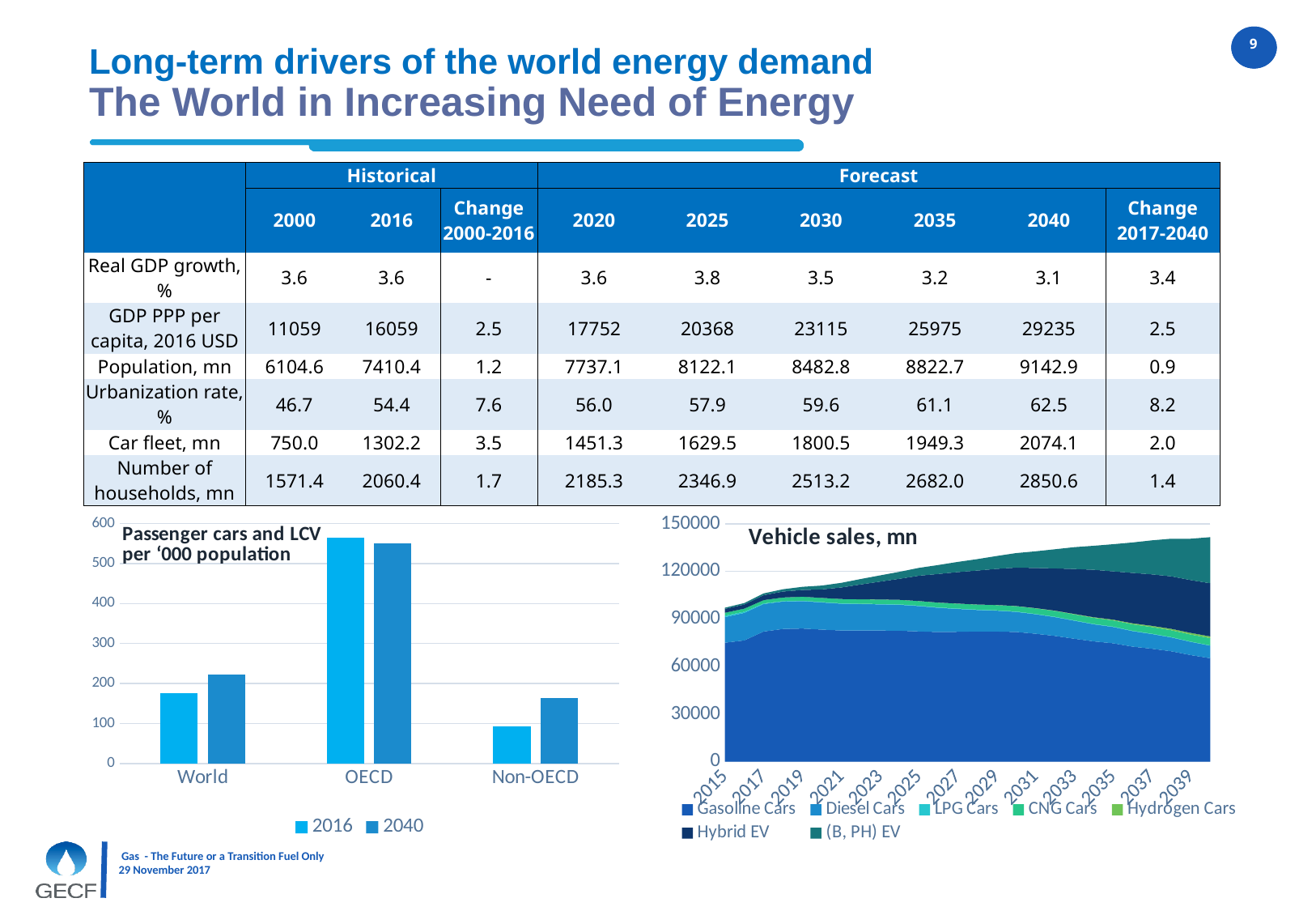
How many series does the legend of the 'Vehicle sales, mn' chart list? 7 In the 'Passenger cars and LCV per '000 population' chart, which category has the lowest 2016 value? Non-OECD How many series does the legend of the 'Passenger cars and LCV per '000 population' chart list? 2 How many categories are shown on the x axis of the 'Passenger cars and LCV per '000 population' chart? 3 In the 'Passenger cars and LCV per '000 population' chart, which is larger for Non-OECD: the 2016 value or the 2040 value? 2040 In the 'Passenger cars and LCV per '000 population' chart, is the 2016 value for OECD greater or less than 500? greater What kind of chart is the 'Passenger cars and LCV per '000 population' chart? bar chart What is the title of the chart on the right side of the slide? Vehicle sales, mn In the 'Passenger cars and LCV per '000 population' chart, is the 2040 value for World greater or less than 200? greater In the 'Passenger cars and LCV per '000 population' chart, which category has the highest values? OECD In the 'Vehicle sales, mn' chart, do total vehicle sales rise or fall from 2015 to 2039? rise